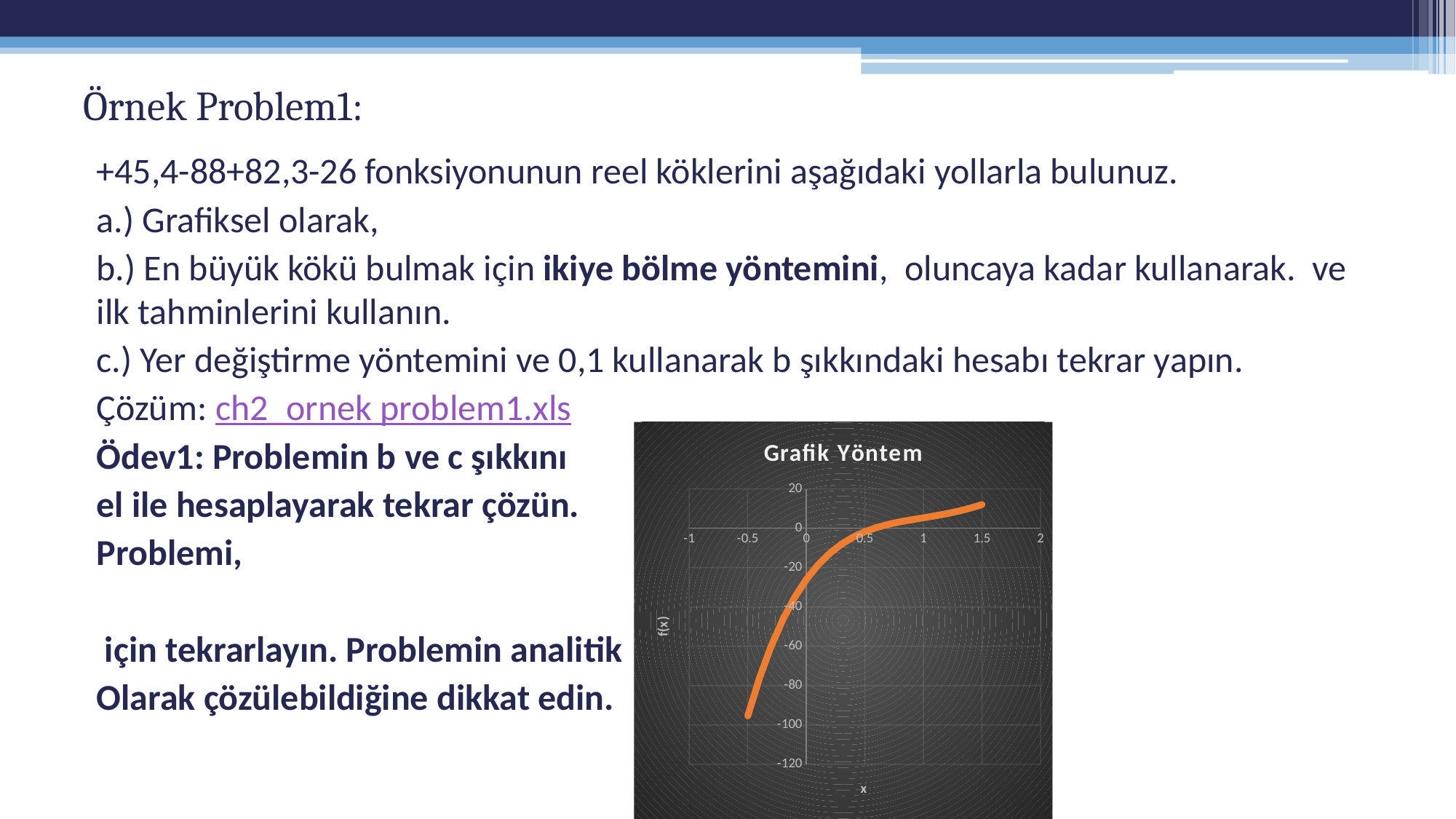
Is the value of f(x) at x = -0.5 greater or less than -80? less How many tick labels are shown on the horizontal axis? 7 What is the label of the vertical axis of the chart? f(x) Is the value of f(x) at x = 1.5 greater or less than 0? greater What is the lowest tick value shown on the vertical axis? -120 Does the plotted line rise or fall as x increases? rises What is the title of the chart? Grafik Yöntem Is the value of f(x) at x = 1 greater or less than -20? greater What kind of chart is shown on the slide? line chart Which is larger, f(x) at x = 0.5 or f(x) at x = -0.5? f(x) at x = 0.5